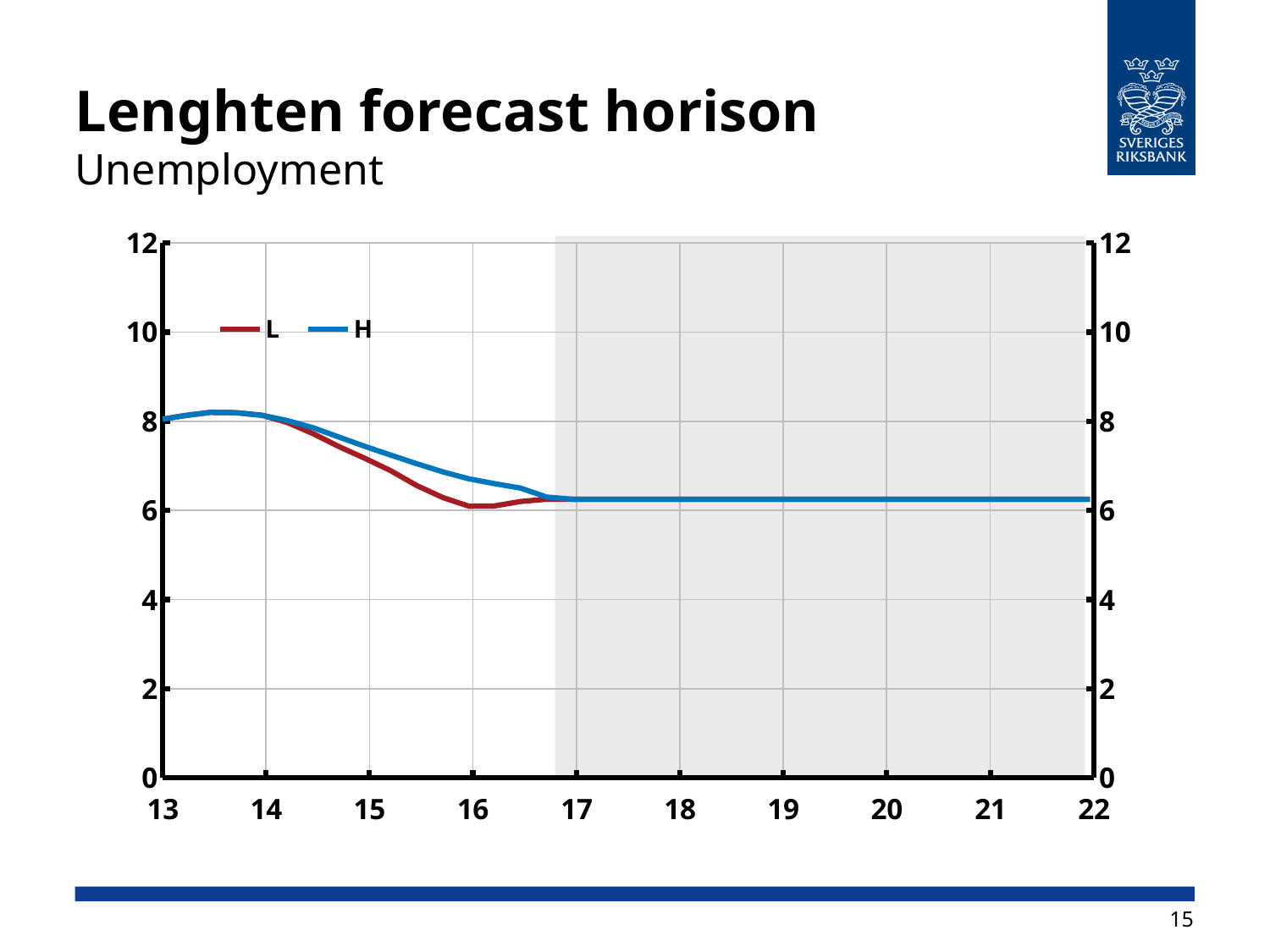
Is the value of series H at 22 greater or less than 8? less What are the two series named in the legend? L and H Is the value of series H at 13 greater or less than 6? greater Between 14 and 16 on the x axis, does series L rise or fall? fall Is the value of series L at 16 greater or less than 8? less How many series does the legend list? 2 What kind of chart is shown on the slide? line chart How many year labels are shown on the x axis? 10 What is the subtitle of the chart below the main title? Unemployment At 15 on the x axis, which series has the higher value, L or H? H From 17 to 22 on the x axis, does series H rise, fall, or stay flat? stay flat